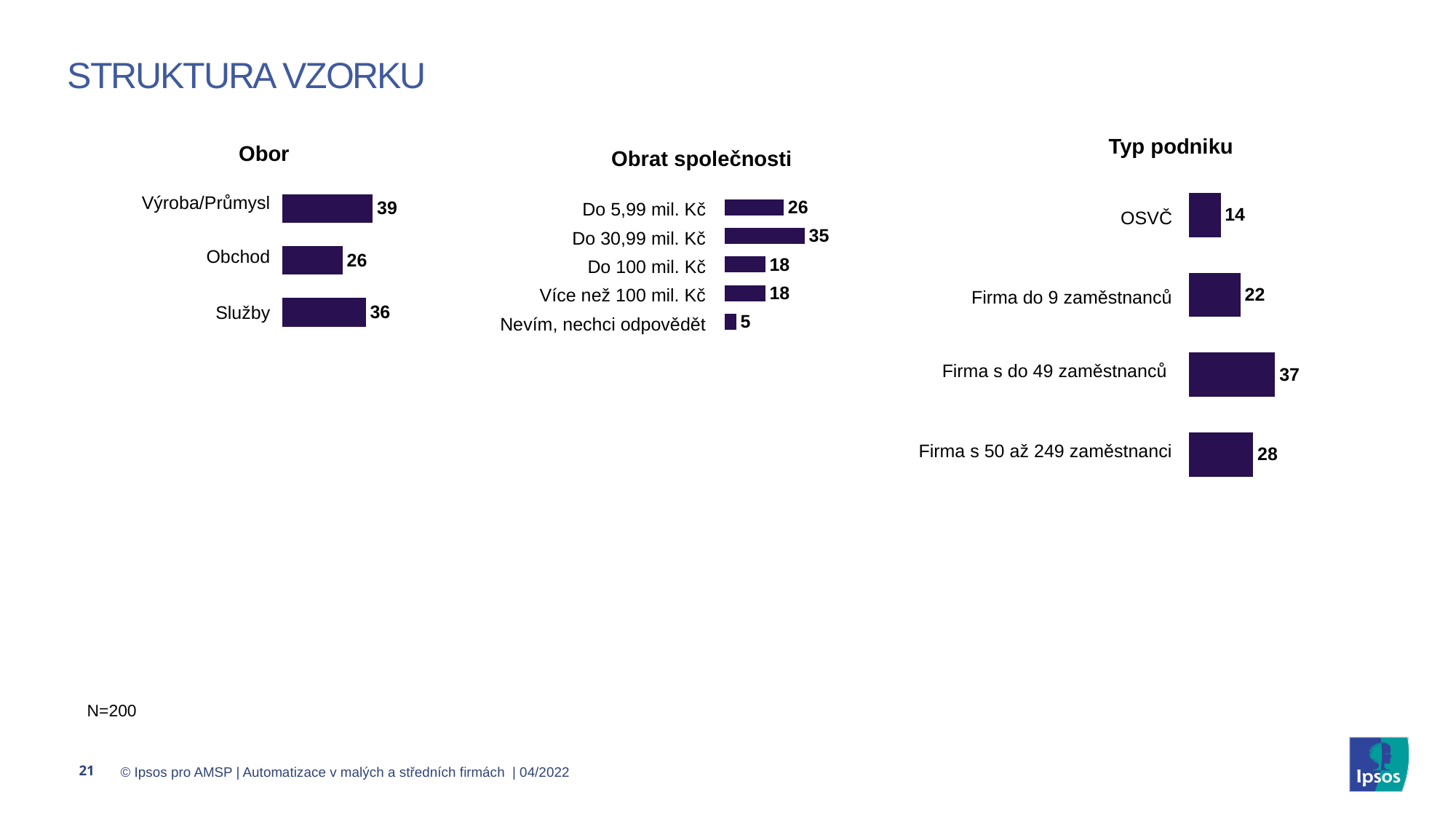
How many categories does the 'Obrat společnosti' chart show? 5 In the 'Typ podniku' chart, which is larger: Firma do 9 zaměstnanců or Firma s 50 až 249 zaměstnanci? Firma s 50 až 249 zaměstnanci In the 'Obrat společnosti' chart, what is the value for Do 30,99 mil. Kč? 35 In the 'Obrat společnosti' chart, which category has the highest value? Do 30,99 mil. Kč In the 'Obor' chart, which category has the lowest value? Obchod In the 'Obor' chart, what is the difference between Výroba/Průmysl and Obchod? 13 In the 'Obor' chart, what is the value for Výroba/Průmysl? 39 What kind of chart is the 'Obor' chart? Bar chart In the 'Typ podniku' chart, which category has the lowest value? OSVČ In the 'Obrat společnosti' chart, what is the value for Nevím, nechci odpovědět? 5 In the 'Typ podniku' chart, what is the difference between Firma s do 49 zaměstnanců and OSVČ? 23 In the 'Typ podniku' chart, what is the value for Firma s do 49 zaměstnanců? 37